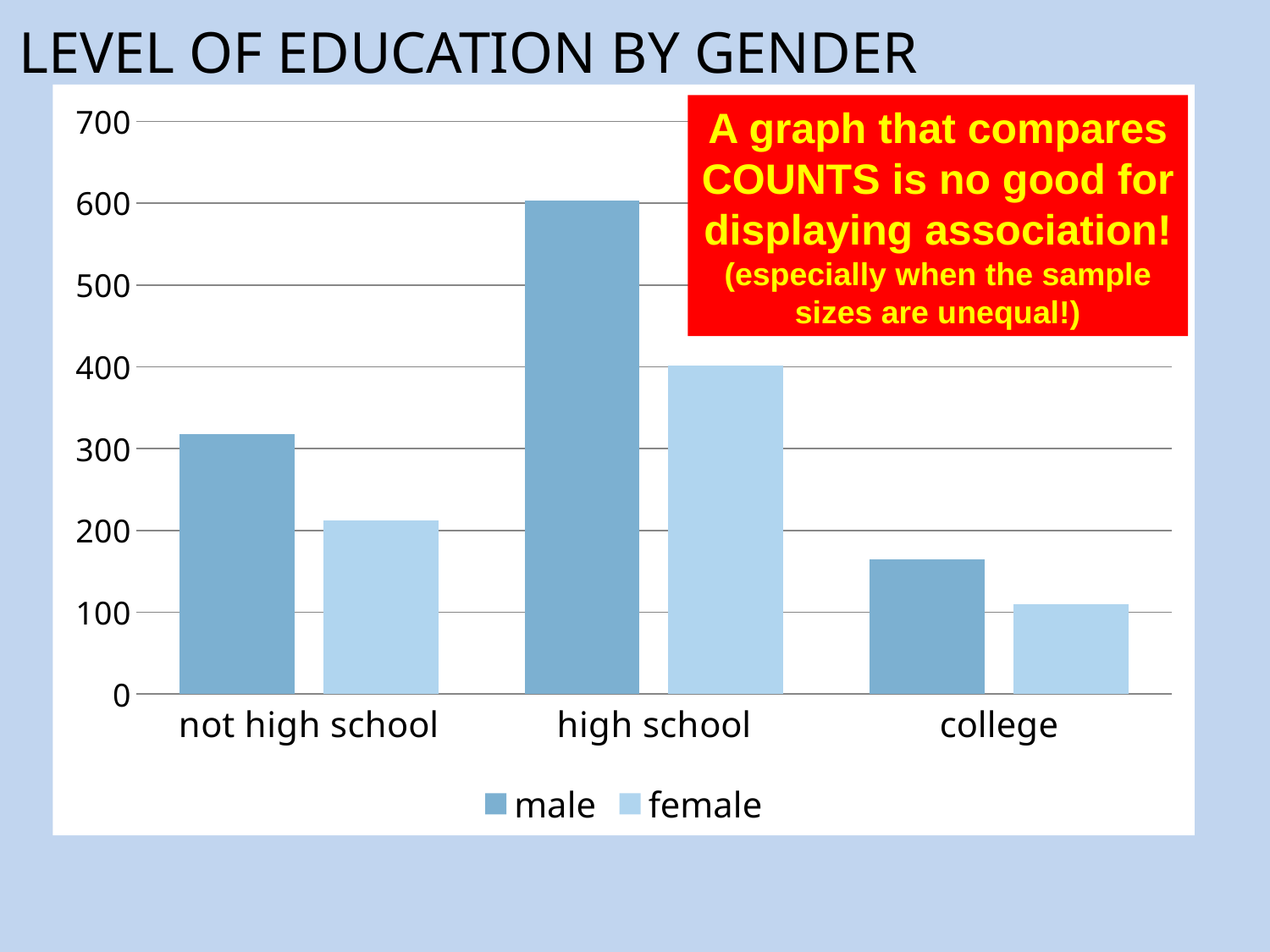
Which education level has the lowest female count? college Which education level has the highest male count? high school Is the male count for not high school greater or less than 400? less Is the male count for high school greater or less than 500? greater What kind of chart is shown on the slide? bar chart Is the male count for college greater or less than 200? less For the college category, which is larger, the male count or the female count? male How many series does the legend list? 2 What is the title of the chart? LEVEL OF EDUCATION BY GENDER How many education-level categories are shown on the x axis? 3 Which education level has the lowest male count? college